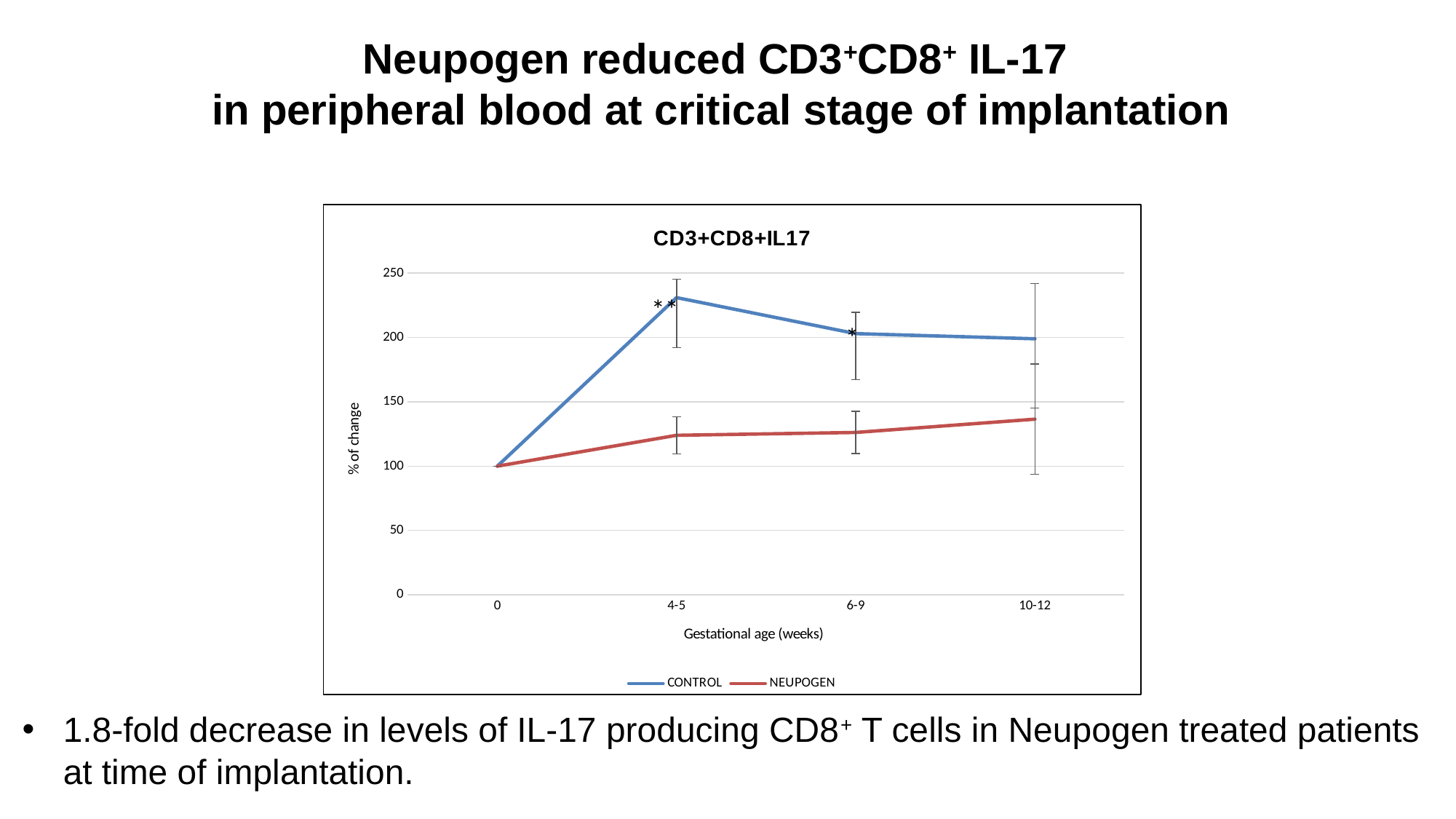
At which gestational age does the CONTROL series reach its highest value? 4-5 How many gestational age categories are shown on the x axis? 4 Does the NEUPOGEN series rise or fall from gestational age 0 to 10-12 weeks? rise What is the label of the y axis? % of change Is the NEUPOGEN value at gestational age 6-9 weeks greater or less than 150? less Is the CONTROL value at gestational age 10-12 weeks greater or less than 150? greater Is the CONTROL value at gestational age 4-5 weeks greater or less than 200? greater At gestational age 4-5 weeks, which series has the larger value, CONTROL or NEUPOGEN? CONTROL What is the title of the chart? CD3+CD8+IL17 At which gestational age is the NEUPOGEN series at its lowest value? 0 What kind of chart is shown on the slide? line chart How many series does the legend list? 2